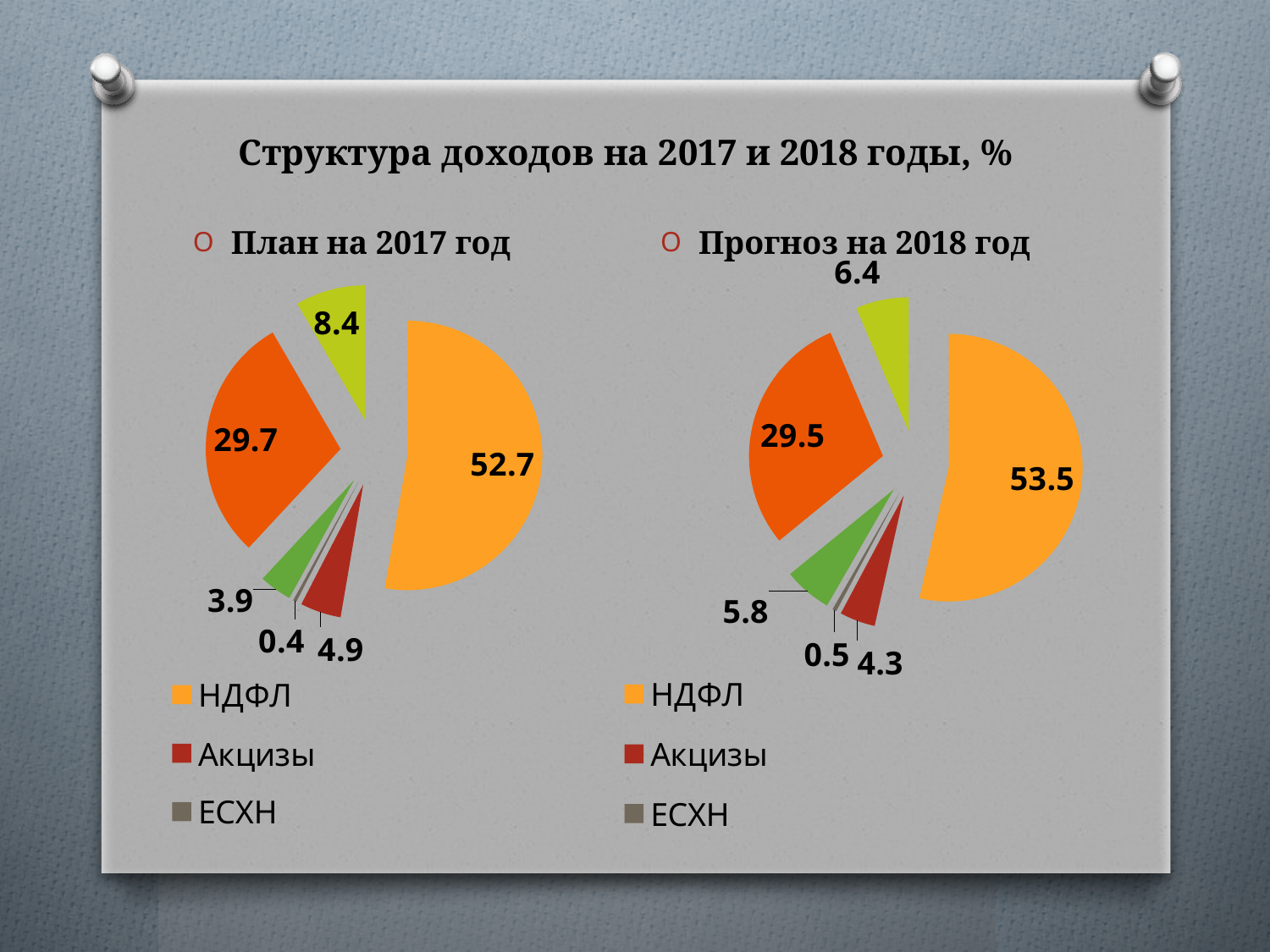
In the chart 'Прогноз на 2018 год', which category has the smallest slice? ЕСХН How many slices does the chart 'Прогноз на 2018 год' have? 6 In the chart 'План на 2017 год', what is the value for НДФЛ? 52.7 Is the value for Акцизы larger in the chart 'План на 2017 год' or in the chart 'Прогноз на 2018 год'? План на 2017 год In the chart 'План на 2017 год', what is the difference between the values for Акцизы and ЕСХН? 4.5 In the chart 'План на 2017 год', what is the value for Акцизы? 4.9 In the chart 'Прогноз на 2018 год', what is the value for ЕСХН? 0.5 In the chart 'Прогноз на 2018 год', what is the value for НДФЛ? 53.5 What kind of chart is 'План на 2017 год'? Pie chart In the chart 'Прогноз на 2018 год', what is the value for Акцизы? 4.3 In the chart 'План на 2017 год', which category has the largest slice? НДФЛ In the chart 'План на 2017 год', what is the value for ЕСХН? 0.4